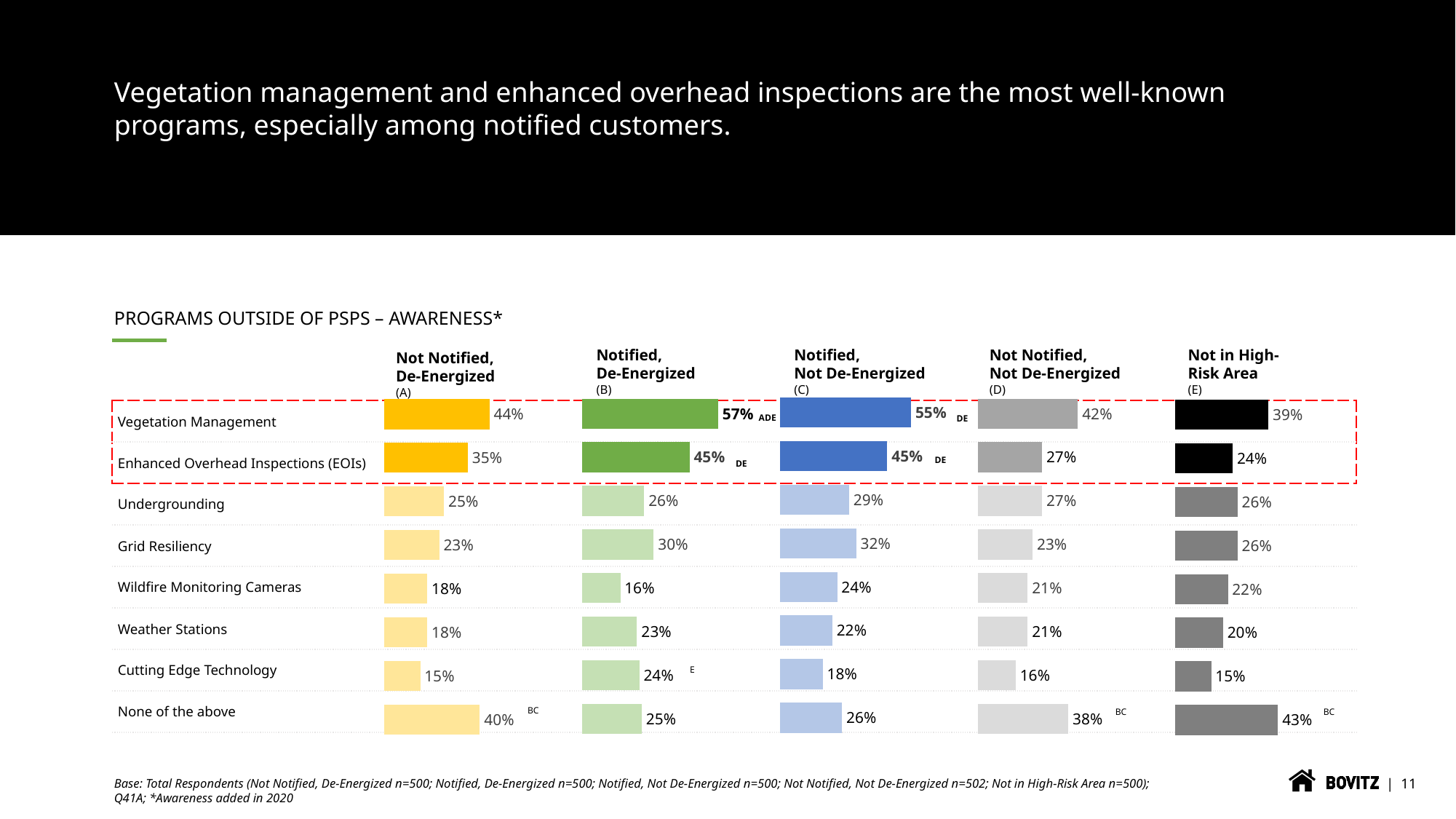
In the Notified, De-Energized chart, what is the awareness value for Vegetation Management? 57% How many programs are listed in each chart? 8 What kind of chart is used to show the awareness values? Bar chart What is the title of the chart section on the slide? PROGRAMS OUTSIDE OF PSPS – AWARENESS* In the Notified, De-Energized chart, what is the difference between Vegetation Management and Enhanced Overhead Inspections (EOIs)? 12% In the Notified, Not De-Energized chart, which program has the highest awareness? Vegetation Management What is the difference between the None of the above values in the Not in High-Risk Area chart and the Notified, De-Energized chart? 18% In the Not Notified, Not De-Energized chart, what is the value for Enhanced Overhead Inspections (EOIs)? 27% In the Not Notified, De-Energized chart, which program has the lowest value? Cutting Edge Technology In the Not in High-Risk Area chart, what is the value for Weather Stations? 20% For Grid Resiliency, which is larger: the Notified, Not De-Energized value or the Not Notified, De-Energized value? Notified, Not De-Energized In the Not in High-Risk Area chart, what is the value for None of the above? 43%